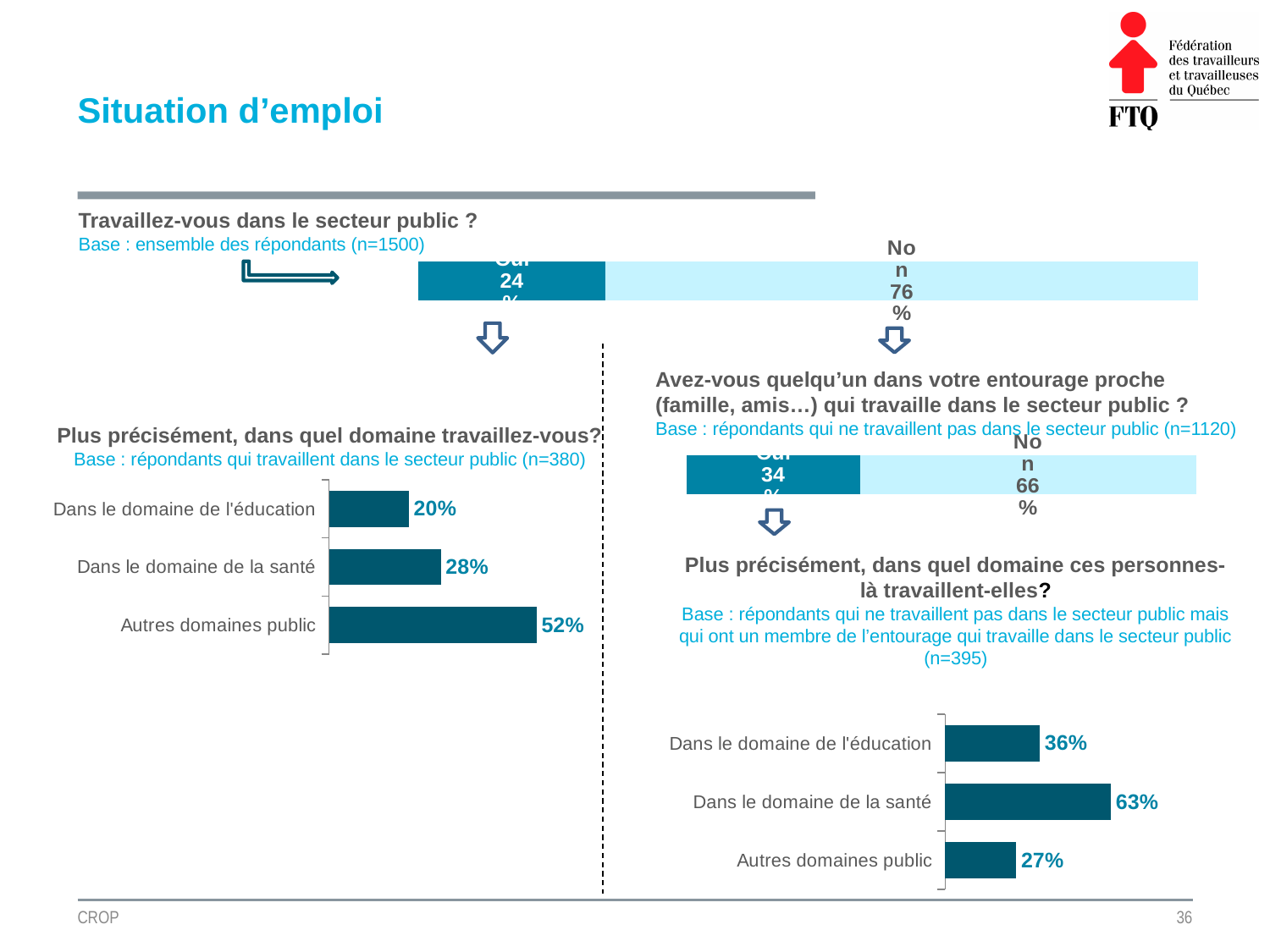
In the bar chart 'Plus précisément, dans quel domaine ces personnes-là travaillent-elles?', what is the value for 'Dans le domaine de l'éducation'? 36% In the bar chart 'Plus précisément, dans quel domaine travaillez-vous?', what is the value for 'Dans le domaine de la santé'? 28% In the bar chart 'Plus précisément, dans quel domaine travaillez-vous?', how many categories are shown? 3 In the bar chart 'Plus précisément, dans quel domaine ces personnes-là travaillent-elles?', which category has the highest value? Dans le domaine de la santé In the bar chart 'Plus précisément, dans quel domaine travaillez-vous?', which category has the highest value? Autres domaines public In the bar chart 'Plus précisément, dans quel domaine travaillez-vous?', what is the difference between 'Autres domaines public' and 'Dans le domaine de l'éducation'? 32 percentage points In the stacked bar for 'Travaillez-vous dans le secteur public ?', what is the value for 'Non'? 76% In the bar chart 'Plus précisément, dans quel domaine ces personnes-là travaillent-elles?', which category has the lowest value? Autres domaines public In the bar chart 'Plus précisément, dans quel domaine ces personnes-là travaillent-elles?', which is larger: 'Dans le domaine de l'éducation' or 'Autres domaines public'? Dans le domaine de l'éducation What kind of chart is used for 'Plus précisément, dans quel domaine travaillez-vous?'? Bar chart In the bar chart 'Plus précisément, dans quel domaine ces personnes-là travaillent-elles?', what is the difference between 'Dans le domaine de la santé' and 'Autres domaines public'? 36 percentage points In the bar chart 'Plus précisément, dans quel domaine travaillez-vous?', which category has the lowest value? Dans le domaine de l'éducation